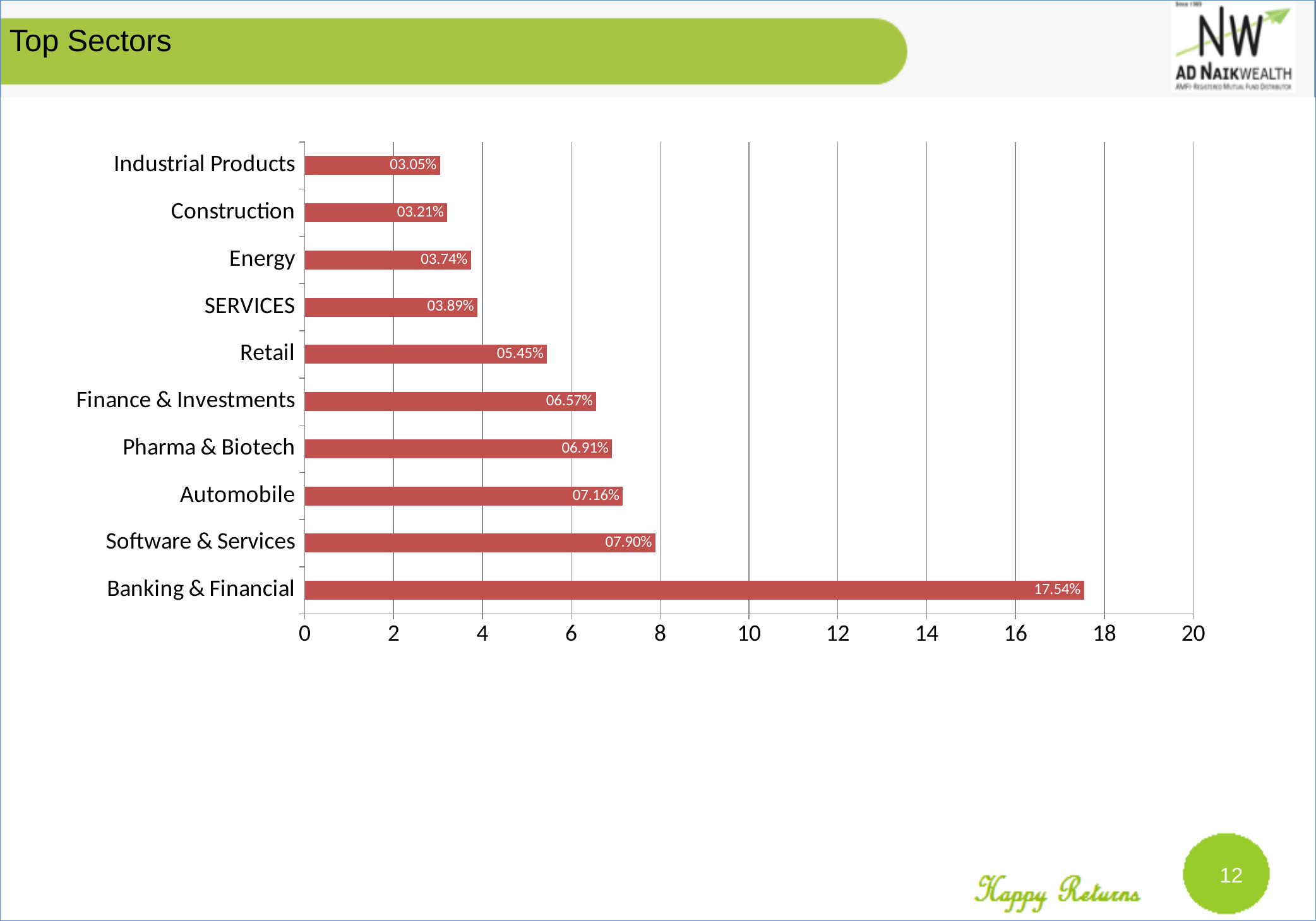
Is the value for Finance & Investments greater or less than 6? greater What is the value for Retail? 05.45% Which sector has the lowest value? Industrial Products What kind of chart is shown on the slide? Bar chart What is the title of the slide? Top Sectors What is the value for Banking & Financial? 17.54% Which is larger, Retail or SERVICES? Retail What is the difference between Automobile and Pharma & Biotech? 0.25% How many sectors are shown in the chart? 10 Which sector has the highest value? Banking & Financial What is the value for Energy? 03.74% What is the difference between Banking & Financial and Software & Services? 9.64%